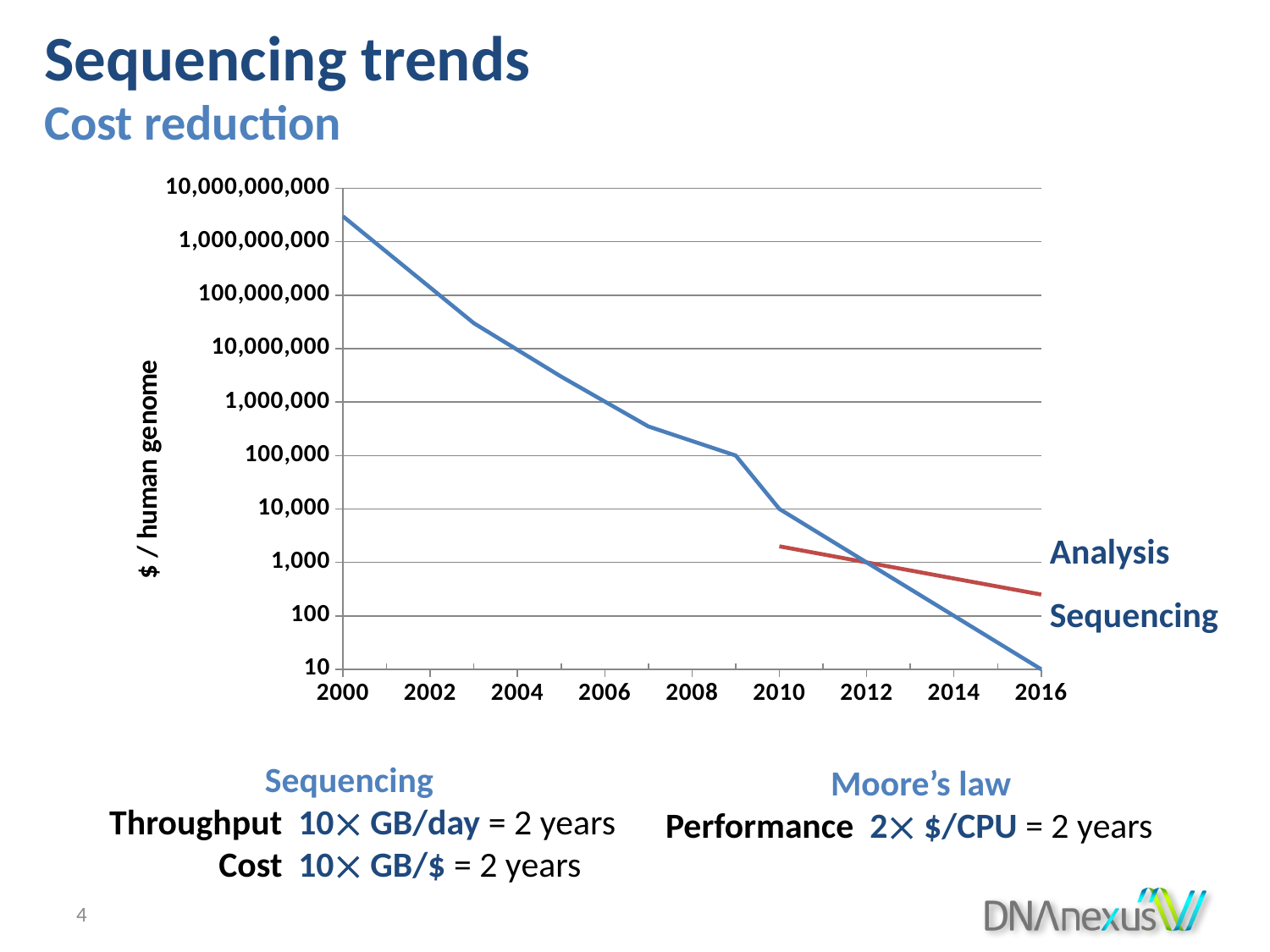
What is the label of the y axis? $ / human genome Is the Sequencing value in 2000 greater or less than 1,000,000,000? greater Is the Sequencing value in 2014 greater or less than 1,000? less Which colour is the Analysis line? red In 2014, which line is higher, Analysis or Sequencing? Analysis Is the Analysis value in 2016 greater or less than 100? greater How many lines (series) are plotted on the chart? 2 Does the Sequencing line rise or fall from 2000 to 2016? fall What kind of chart is shown on the slide? line chart Does the Analysis line rise or fall from 2010 to 2016? fall In 2010, which line is higher, Analysis or Sequencing? Sequencing